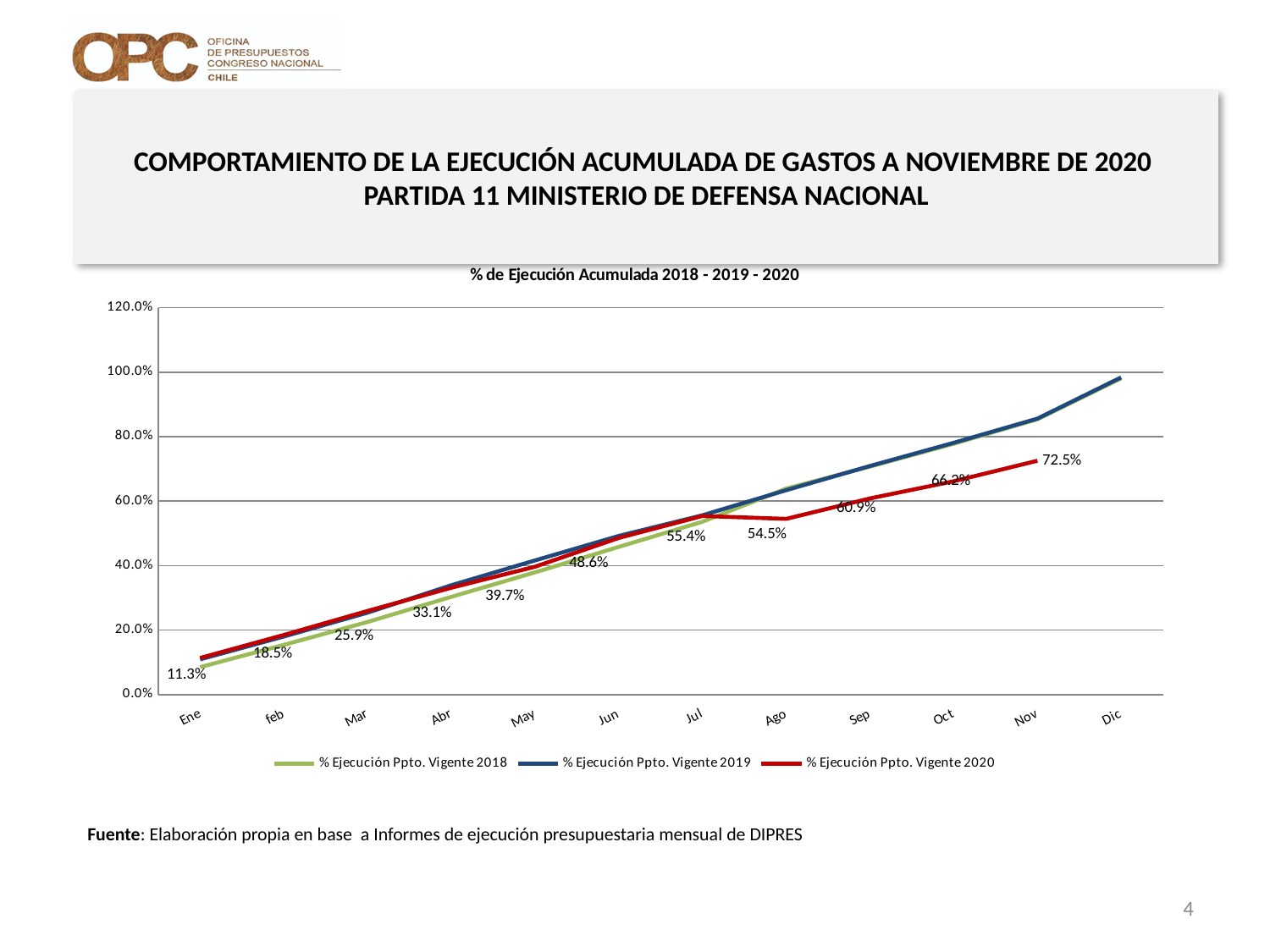
Is the value of % Ejecución Ppto. Vigente 2019 in Dic greater or less than 80%? greater How many months are shown along the x axis? 12 Do the values of % Ejecución Ppto. Vigente 2019 rise or fall from Ene to Dic? Rise How many series does the legend list? 3 Which is larger for the 2020 series, the value in Jul or the value in Ago? Jul What is the value of % Ejecución Ppto. Vigente 2020 in Jul? 55.4% What is the value of % Ejecución Ppto. Vigente 2020 in Ene? 11.3% What is the value of % Ejecución Ppto. Vigente 2020 in Nov? 72.5% What is the title of the chart? % de Ejecución Acumulada 2018 - 2019 - 2020 What kind of chart is shown on the slide? Line chart What is the difference between the 2020 values for Nov and Ene? 61.2 percentage points What is the value of % Ejecución Ppto. Vigente 2020 in Ago? 54.5%